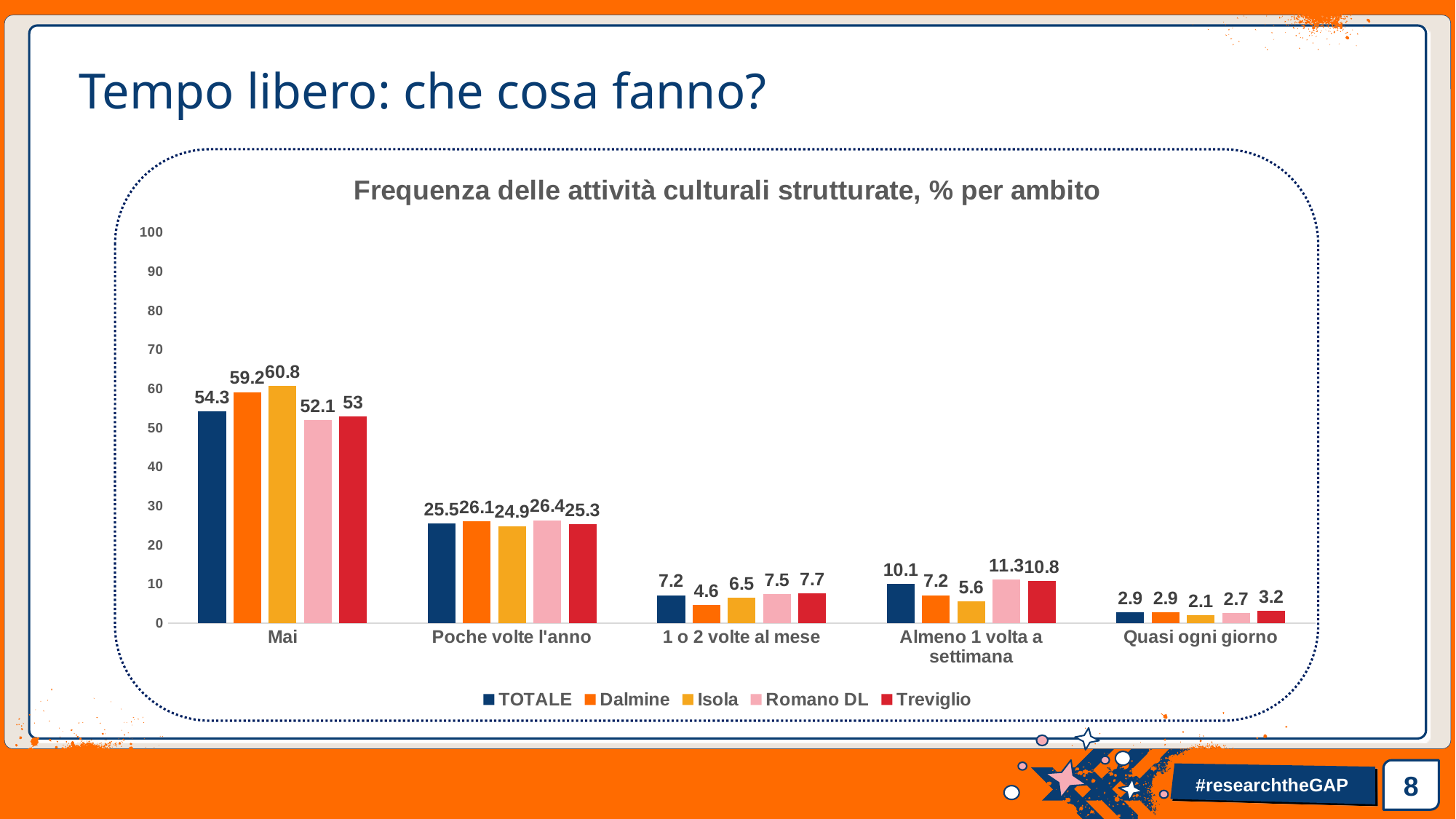
Which series has the lowest value in the "Quasi ogni giorno" category? Isola How many categories are shown on the x axis? 5 How many series does the legend list? 5 Which series has the highest value in the "Mai" category? Isola What is the difference between the Isola and Romano DL values in the "Mai" category? 8.7 What kind of chart is shown on the slide? Bar chart In the "Almeno 1 volta a settimana" category, which is larger: the value for TOTALE or the value for Isola? TOTALE What is the value for Dalmine in the "1 o 2 volte al mese" category? 4.6 What is the title of the chart? Frequenza delle attività culturali strutturate, % per ambito What is the value for Romano DL in the "Almeno 1 volta a settimana" category? 11.3 What is the value for Isola in the "Mai" category? 60.8 Is the value for Dalmine in the "Mai" category greater or less than 50? greater